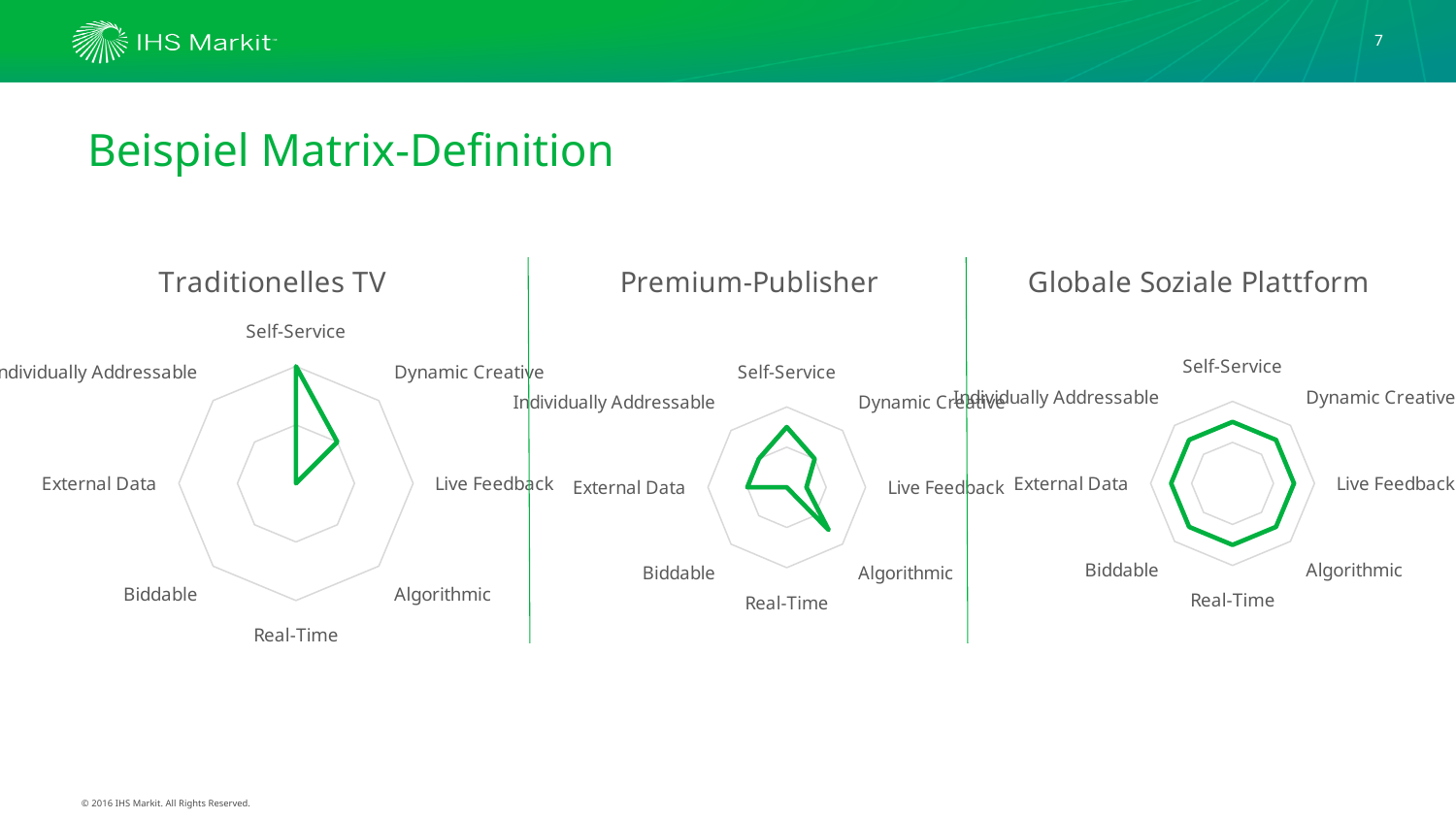
How many charts are shown on the slide? 3 What is the title of the chart in the middle of the slide? Premium-Publisher In the "Traditionelles TV" chart, which category has the highest value? Self-Service How many categories (axes) does the "Premium-Publisher" radar chart have? 8 In the "Traditionelles TV" chart, which is larger: the value for Self-Service or the value for Biddable? Self-Service In the "Premium-Publisher" chart, which is larger: the value for Algorithmic or the value for Biddable? Algorithmic What kind of chart is the "Traditionelles TV" chart? Radar chart How many categories (axes) does the "Globale Soziale Plattform" radar chart have? 8 What is the title of the chart on the right of the slide? Globale Soziale Plattform In the "Traditionelles TV" chart, which is larger: the value for Dynamic Creative or the value for External Data? Dynamic Creative